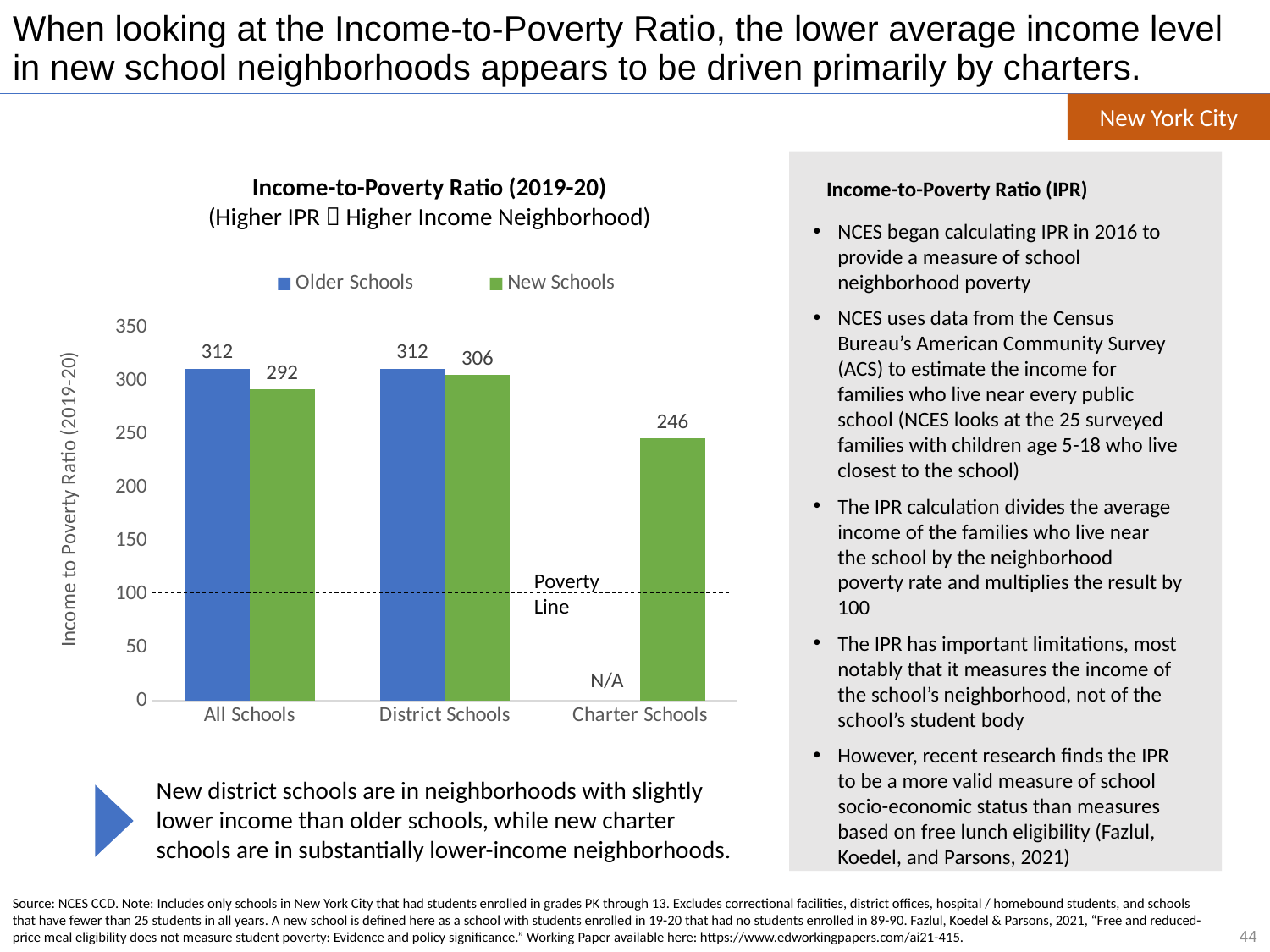
What is the Income-to-Poverty Ratio for Older Schools in the All Schools category? 312 How many series does the legend list? 2 What is the difference between the New Schools values for District Schools and Charter Schools? 60 How many categories are shown on the x axis? 3 What is the Income-to-Poverty Ratio for New Schools in the Charter Schools category? 246 What is the Income-to-Poverty Ratio for New Schools in the District Schools category? 306 Is the New Schools value for Charter Schools greater or less than 250? less Which category has the lowest value for New Schools? Charter Schools What is the difference between the Older Schools and New Schools values for All Schools? 20 What kind of chart is shown on the slide? bar chart What value is shown for Older Schools in the Charter Schools category? N/A Which is larger for District Schools: the Older Schools value or the New Schools value? Older Schools